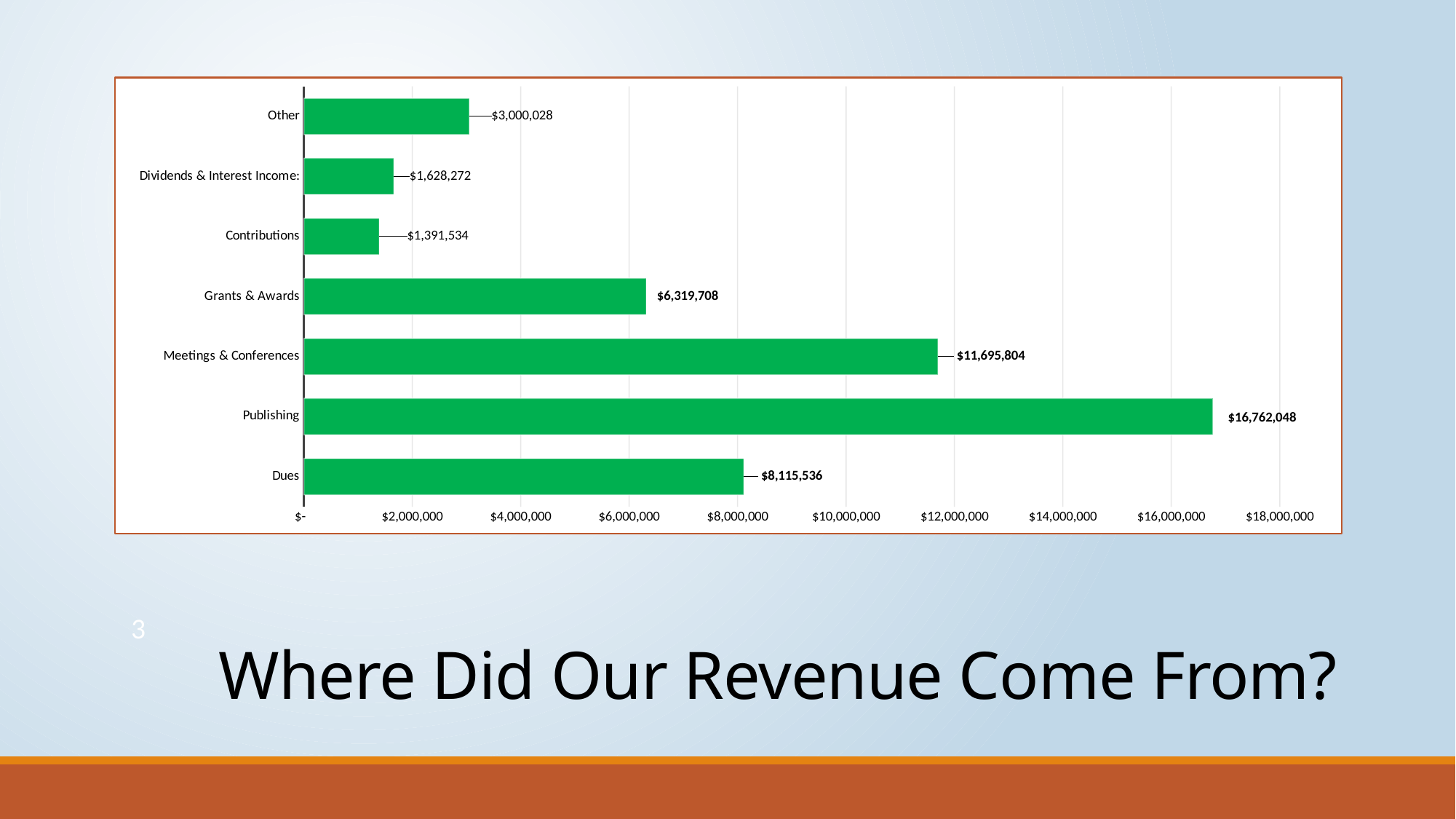
What is the difference between the revenue for Other and the revenue for Dividends & Interest Income? $1,371,756 Which category has the lowest revenue? Contributions What is the revenue value for Contributions? $1,391,534 What is the difference between the revenue for Publishing and the revenue for Meetings & Conferences? $5,066,244 What is the revenue value for Meetings & Conferences? $11,695,804 What kind of chart is shown on the slide? Bar chart Which is larger, the revenue for Grants & Awards or the revenue for Dues? Dues Is the value for Meetings & Conferences greater or less than $12,000,000? less How many revenue categories are shown in the chart? 7 What is the revenue value for Publishing? $16,762,048 What is the revenue value for Dues? $8,115,536 Which category has the highest revenue? Publishing